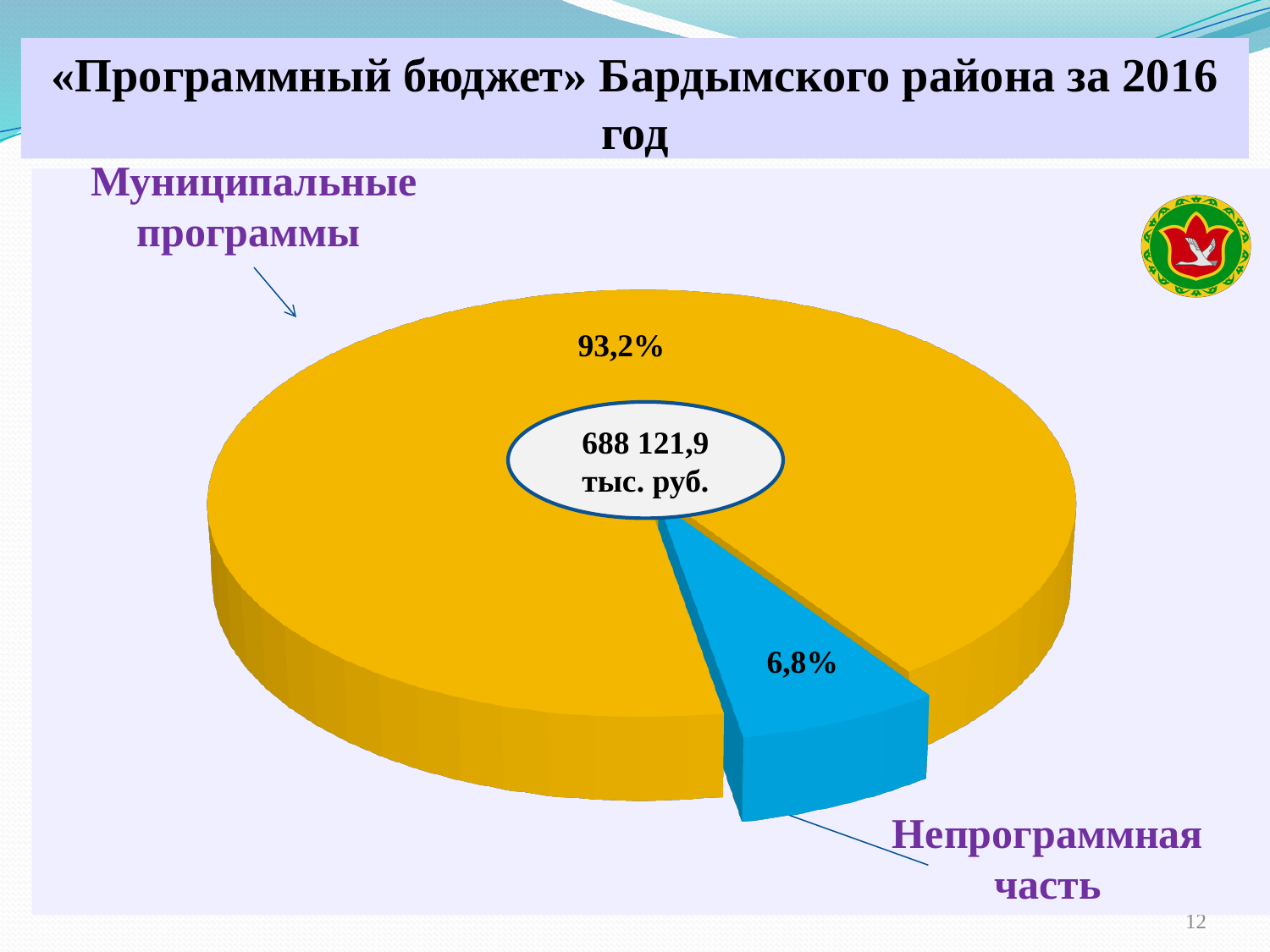
What share of the pie does «Непрограммная часть» take? 6,8% Which slice of the pie is the smallest? Непрограммная часть Which slice of the pie is the largest? Муниципальные программы What is the difference in percentage points between «Муниципальные программы» and «Непрограммная часть»? 86,4 What colour is the «Муниципальные программы» slice? yellow How many slices does the pie chart have? 2 What colour is the «Непрограммная часть» slice? blue What total amount is shown in the centre of the pie chart? 688 121,9 тыс. руб. Which is larger: the share of «Муниципальные программы» or the share of «Непрограммная часть»? Муниципальные программы What kind of chart is shown on the slide? pie chart What share of the pie does «Муниципальные программы» take? 93,2%